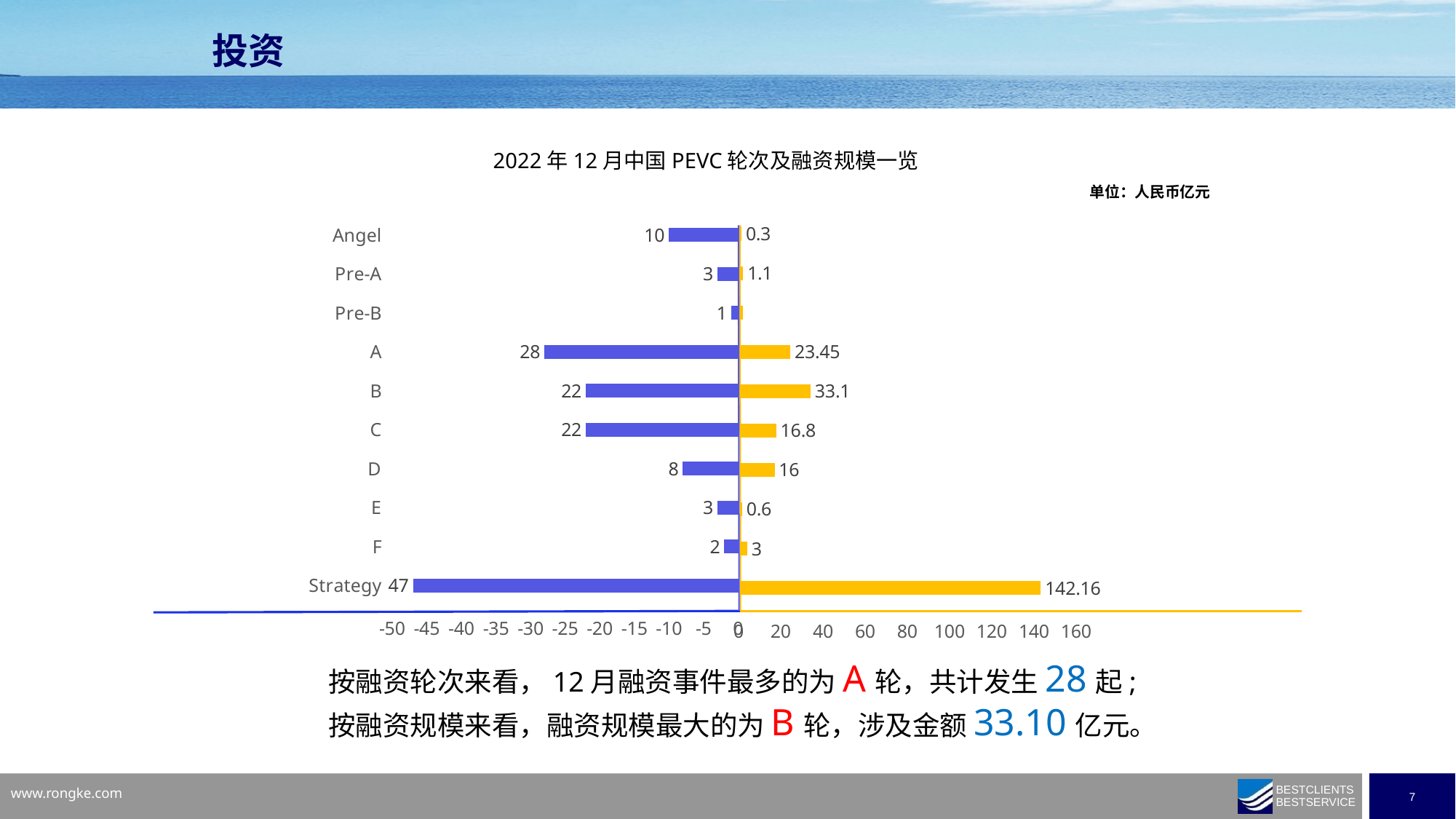
How many categories are shown on the chart? 10 What is the title of the chart? 2022年12月中国PEVC轮次及融资规模一览 Which category has the smallest blue bar? Pre-B What is the difference between the yellow bar values for the B round and the C round? 16.3 What is the value of the blue bar for the A round? 28 What is the value of the blue bar for the D round? 8 Which has a larger yellow bar value, the A round or the D round? A What is the value of the yellow bar for the B round? 33.1 What unit is stated for the chart? 人民币亿元 What is the value of the yellow bar for Strategy? 142.16 Which category has the largest yellow bar? Strategy What kind of chart is shown on the slide? Bar chart